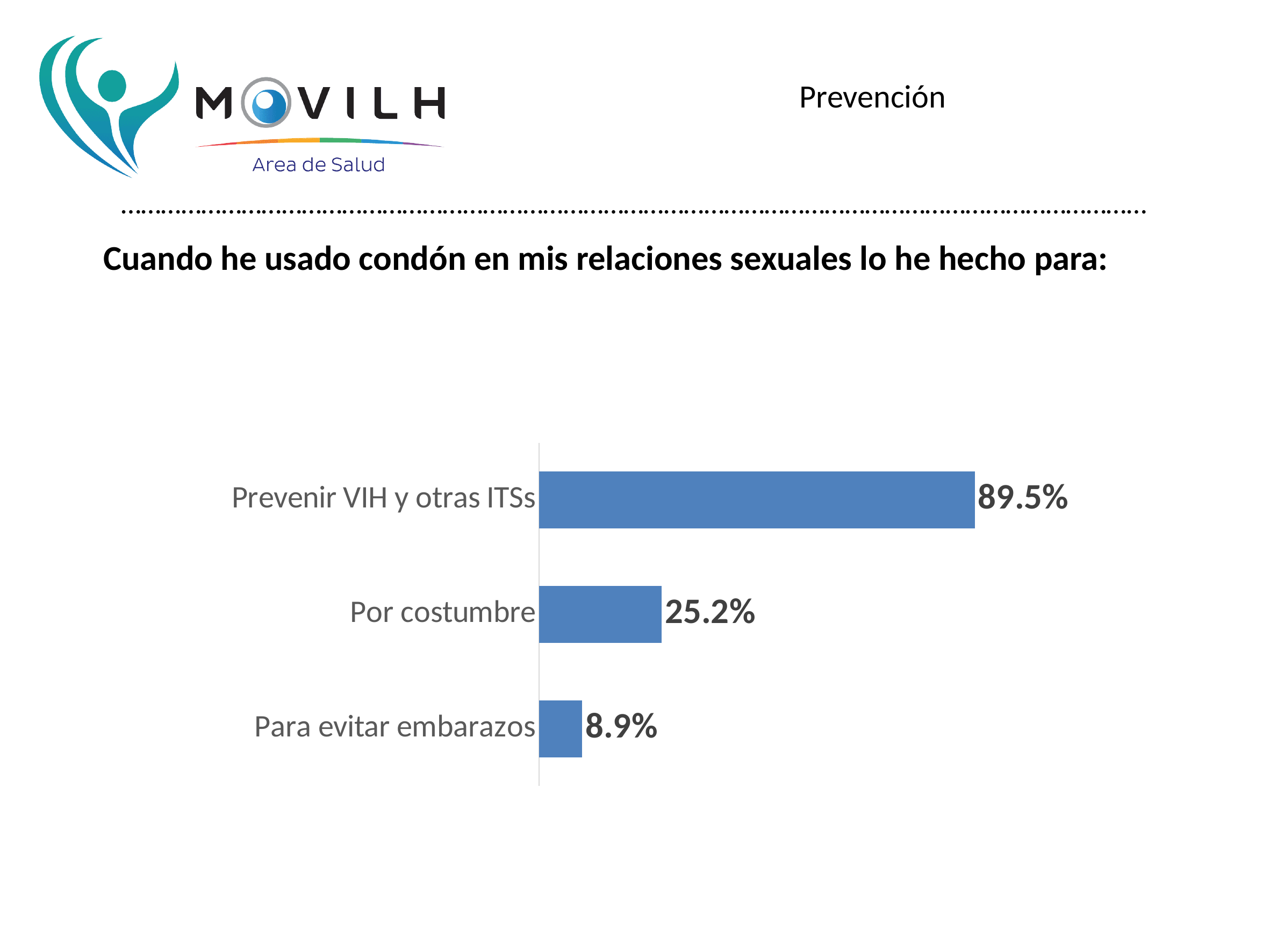
Which category has the lowest value? Para evitar embarazos What is the difference between the values for "Prevenir VIH y otras ITSs" and "Por costumbre"? 64.3% What is the value for "Para evitar embarazos"? 8.9% What kind of chart is shown on the slide? Bar chart What colour are the bars in the chart? Blue Which category has the highest value? Prevenir VIH y otras ITSs What is the value for "Prevenir VIH y otras ITSs"? 89.5% What is the title of the chart? Cuando he usado condón en mis relaciones sexuales lo he hecho para: Which is larger, the value for "Por costumbre" or the value for "Para evitar embarazos"? Por costumbre How many categories are shown in the chart? 3 What is the value for "Por costumbre"? 25.2% What is the difference between the values for "Por costumbre" and "Para evitar embarazos"? 16.3%